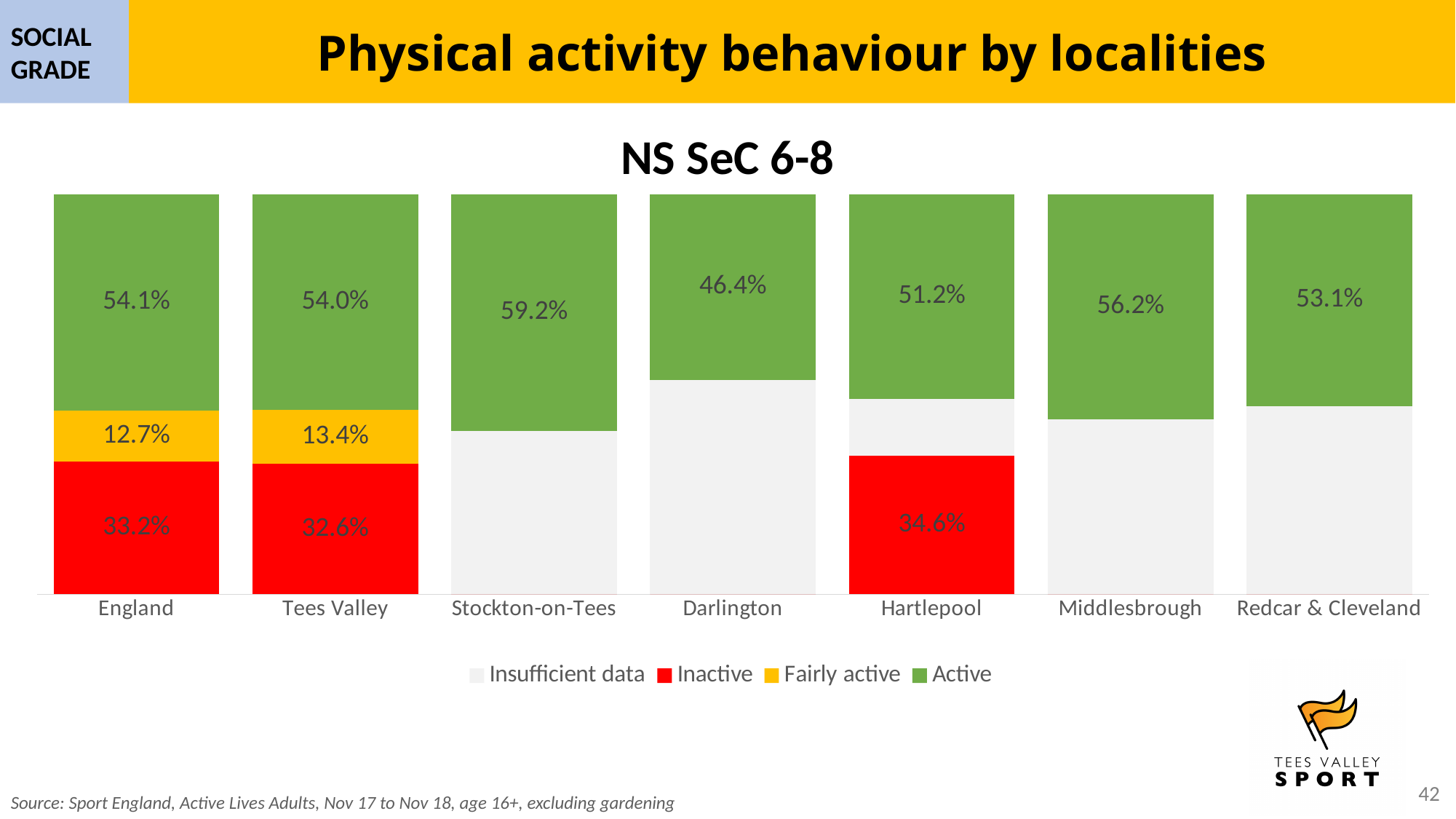
What is the Inactive value for Hartlepool? 34.6% What is the total of the Inactive, Fairly active and Active values for England? 100.0% What is the Fairly active value for Tees Valley? 13.4% What is the difference between the Active values for Stockton-on-Tees and Darlington? 12.8% What is the Active value for Stockton-on-Tees? 59.2% Which has the larger Inactive value, England or Hartlepool? Hartlepool Which locality has the lowest Active value? Darlington What kind of chart is shown? Stacked bar chart How many series does the legend list? 4 Which locality has the highest Active value? Stockton-on-Tees What is the title of the chart? NS SeC 6-8 How many localities are shown on the x axis? 7